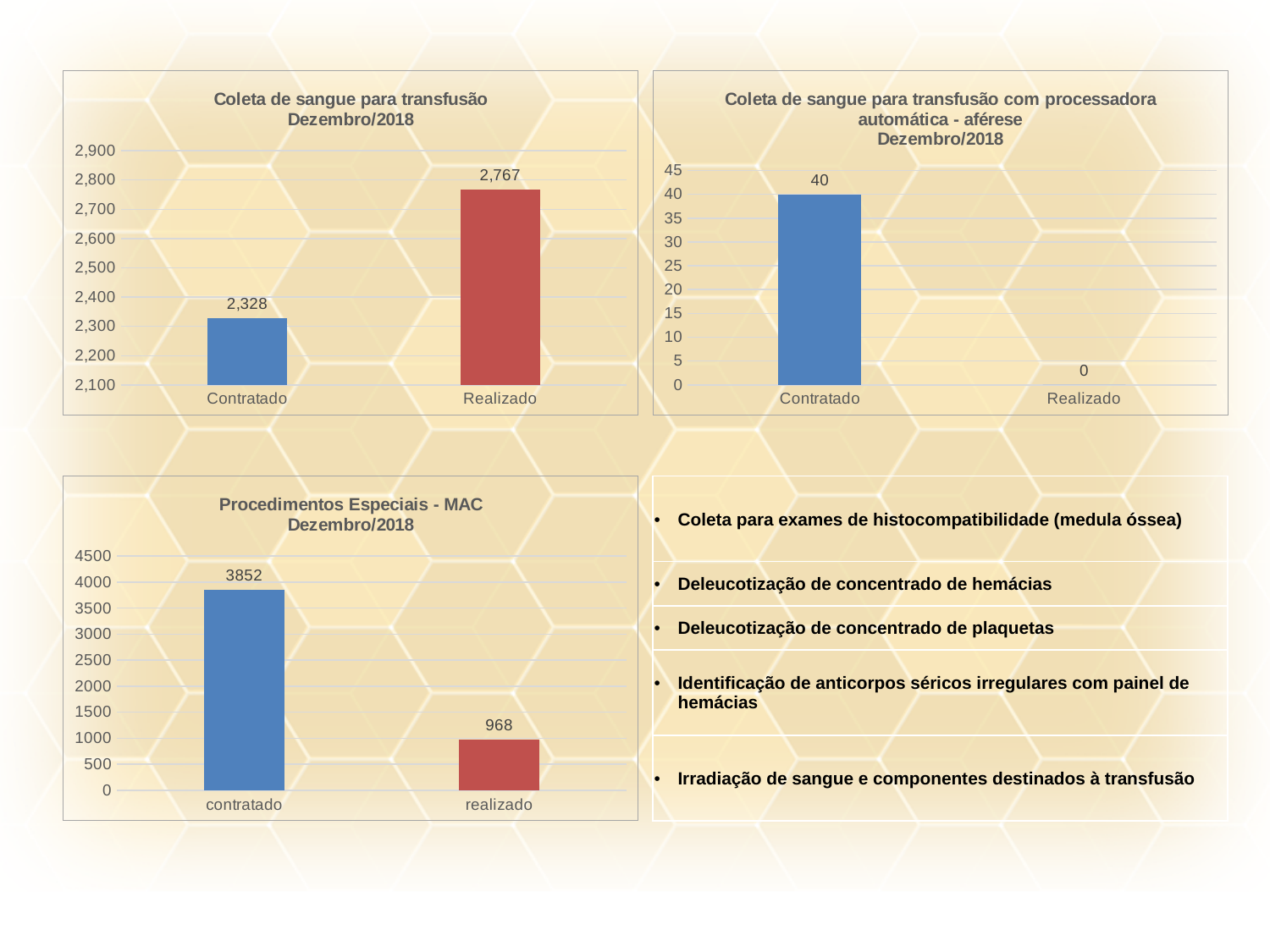
What kind of chart is 'Procedimentos Especiais - MAC Dezembro/2018'? Bar chart In the chart 'Coleta de sangue para transfusão com processadora automática - aférese Dezembro/2018', what is the value for Contratado? 40 In the chart 'Coleta de sangue para transfusão Dezembro/2018', which category is higher, Contratado or Realizado? Realizado In the chart 'Procedimentos Especiais - MAC Dezembro/2018', which category has the highest value? contratado In the chart 'Procedimentos Especiais - MAC Dezembro/2018', what is the value for contratado? 3852 In the chart 'Coleta de sangue para transfusão com processadora automática - aférese Dezembro/2018', what is the value for Realizado? 0 In the chart 'Coleta de sangue para transfusão Dezembro/2018', what is the value for Contratado? 2,328 In the chart 'Procedimentos Especiais - MAC Dezembro/2018', what is the difference between contratado and realizado? 2884 In the chart 'Coleta de sangue para transfusão com processadora automática - aférese Dezembro/2018', which category has the lowest value? Realizado In the chart 'Procedimentos Especiais - MAC Dezembro/2018', what is the value for realizado? 968 In the chart 'Coleta de sangue para transfusão Dezembro/2018', what is the value for Realizado? 2,767 In the chart 'Coleta de sangue para transfusão Dezembro/2018', what is the difference between Realizado and Contratado? 439